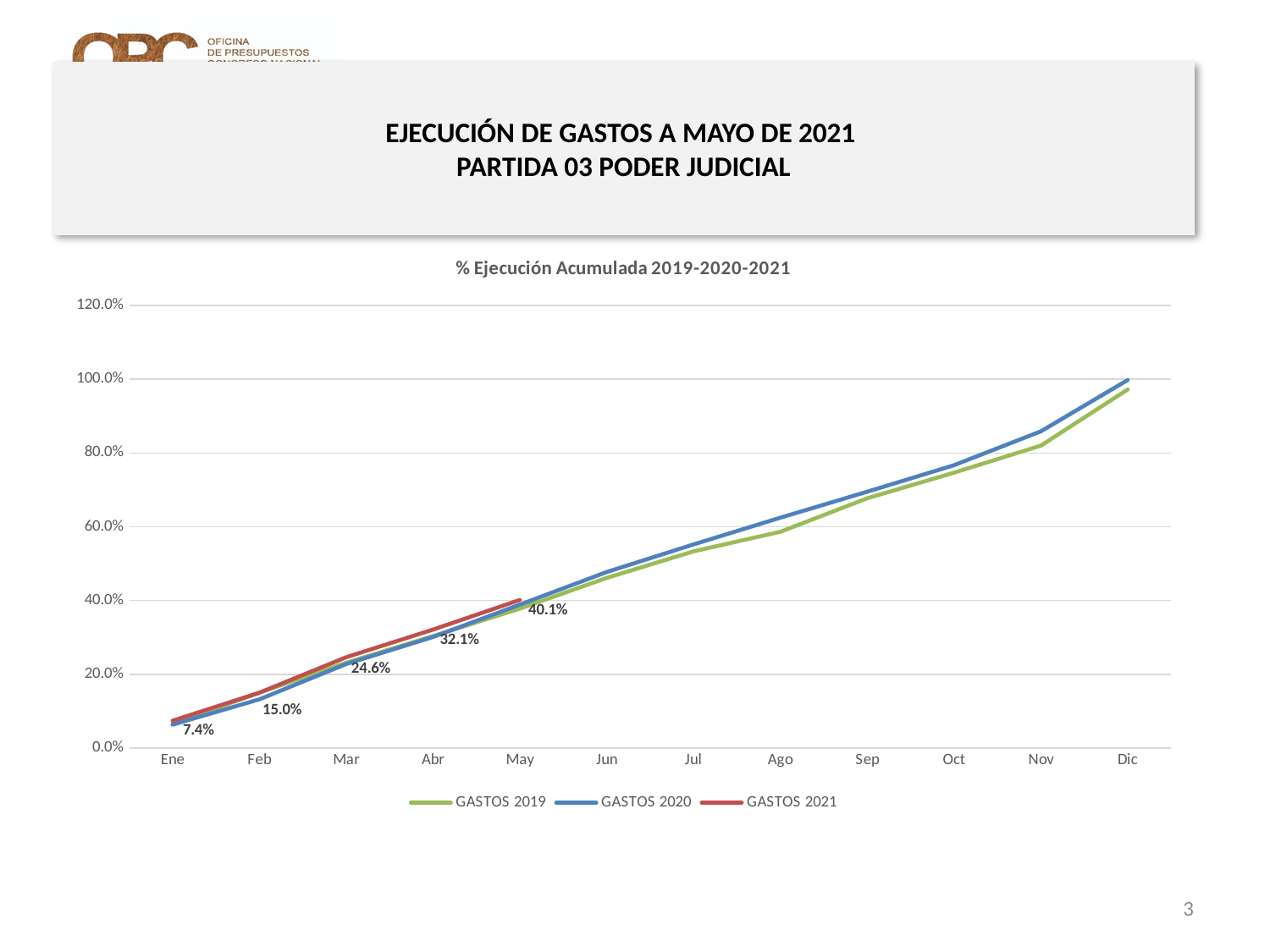
What is the difference between the GASTOS 2021 values for Feb and Ene? 7.6% What is the value for GASTOS 2021 in Mar? 24.6% What is the value for GASTOS 2021 in Ene? 7.4% Which month has the highest labelled value for GASTOS 2021? May What is the difference between the GASTOS 2021 values for May and Abr? 8.0% Is the value for GASTOS 2020 in Oct greater or less than 60.0%? greater What is the value for GASTOS 2021 in May? 40.1% How many series does the legend list? 3 What kind of chart is shown on the slide? Line chart How many months are shown on the x axis? 12 What is the title of the chart? % Ejecución Acumulada 2019-2020-2021 What is the value for GASTOS 2021 in Abr? 32.1%